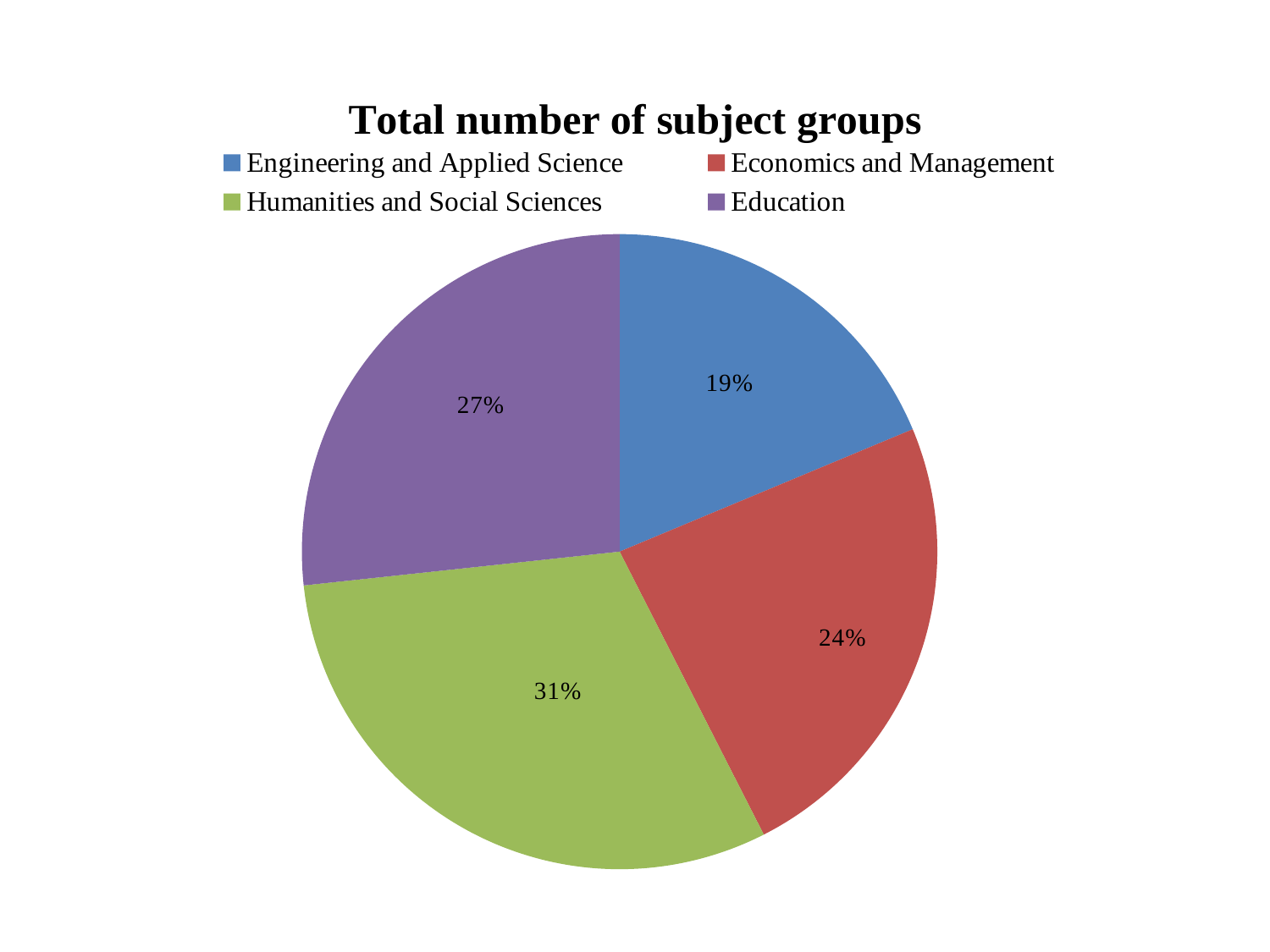
What share of the pie does Engineering and Applied Science have? 19% Which is larger, the share for Education or the share for Economics and Management? Education What kind of chart is shown on the slide? Pie chart Which subject group has the smallest slice of the pie? Engineering and Applied Science How many subject groups are shown in the pie chart? 4 What share of the pie does Economics and Management have? 24% What is the difference in percentage points between Education and Economics and Management? 3 What is the title of the chart? Total number of subject groups What is the difference in percentage points between Humanities and Social Sciences and Engineering and Applied Science? 12 Which subject group has the largest slice of the pie? Humanities and Social Sciences What share of the pie does Education have? 27%